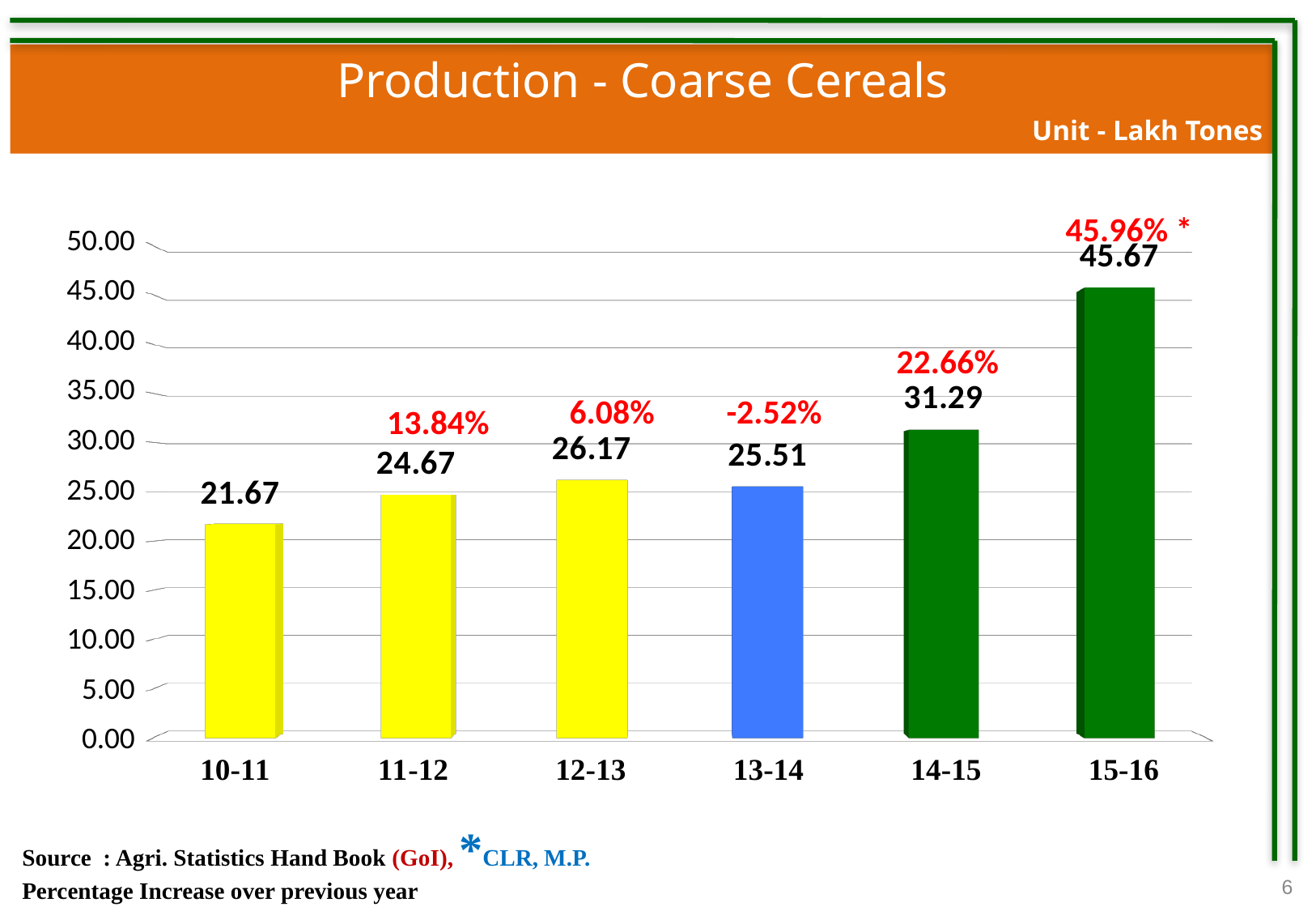
What kind of chart is shown on the slide? bar chart How many years are shown on the x axis? 6 Which year has the lowest production of coarse cereals? 10-11 Which year has higher production, 12-13 or 13-14? 12-13 What unit is stated for the production values? Lakh Tones What percentage increase over the previous year is shown for 14-15? 22.66% Which year has the highest production of coarse cereals? 15-16 Which year shows a negative percentage change over the previous year? 13-14 What is the production of coarse cereals in 10-11? 21.67 What is the difference in production between 15-16 and 14-15? 14.38 What is the production value shown for 13-14? 25.51 Is the production value for 14-15 greater or less than 30.00? greater